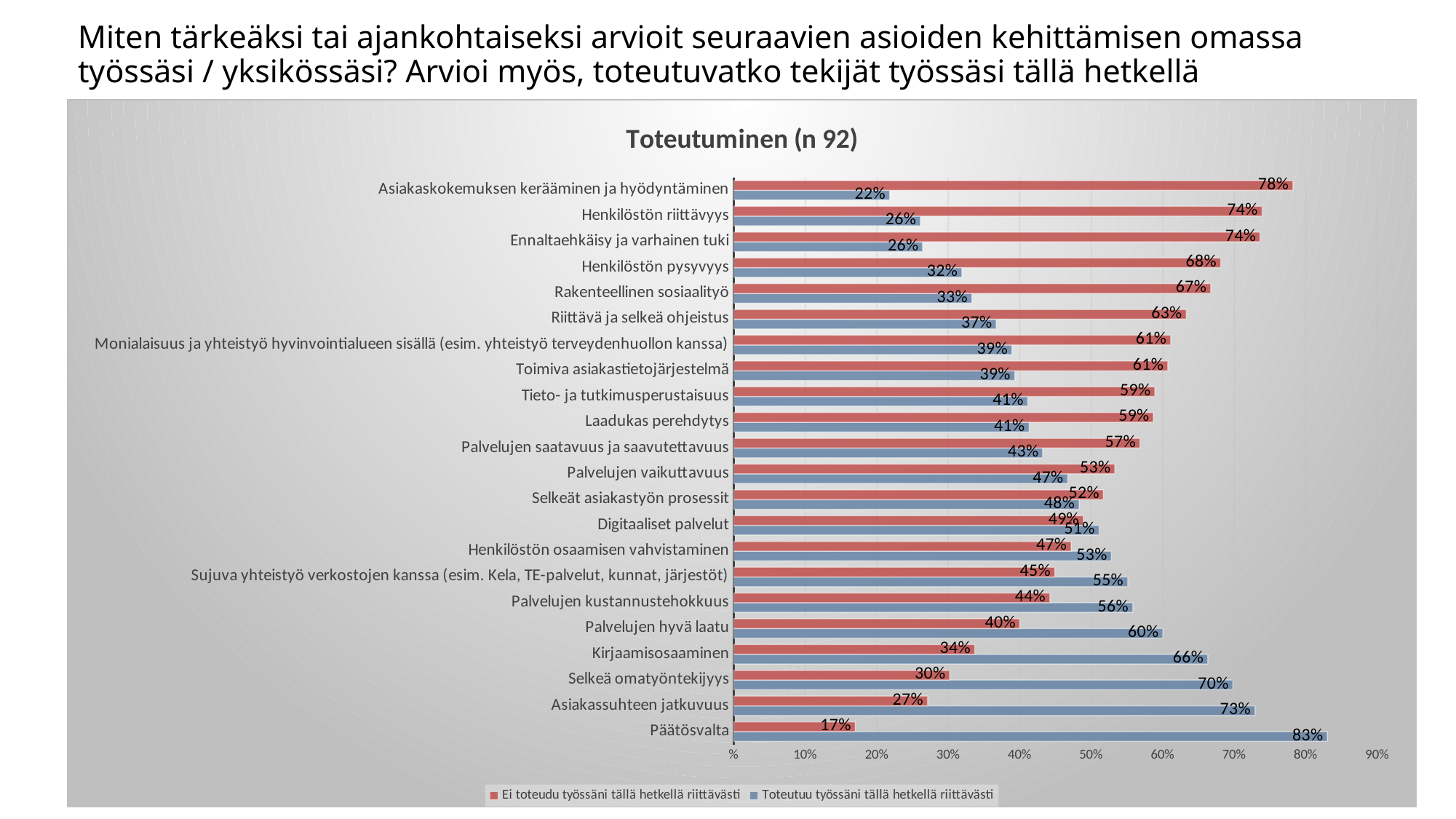
What is the value of "Ei toteudu työssäni tällä hetkellä riittävästi" for Rakenteellinen sosiaalityö? 67% What kind of chart is shown on the slide? Bar chart Which category has the lowest value for "Ei toteudu työssäni tällä hetkellä riittävästi"? Päätösvalta How many series does the legend list? 2 What is the value of "Toteutuu työssäni tällä hetkellä riittävästi" for Kirjaamisosaaminen? 66% What is the difference between the "Ei toteudu" and "Toteutuu" values for Henkilöstön riittävyys? 48% What is the value of "Ei toteudu työssäni tällä hetkellä riittävästi" for Asiakaskokemuksen kerääminen ja hyödyntäminen? 78% How many categories are shown in the chart? 22 What is the title of the chart? Toteutuminen (n 92) For Digitaaliset palvelut, which series has the larger value: "Ei toteudu työssäni tällä hetkellä riittävästi" or "Toteutuu työssäni tällä hetkellä riittävästi"? Toteutuu työssäni tällä hetkellä riittävästi Which category has the highest value for "Toteutuu työssäni tällä hetkellä riittävästi"? Päätösvalta What is the value of "Toteutuu työssäni tällä hetkellä riittävästi" for Päätösvalta? 83%